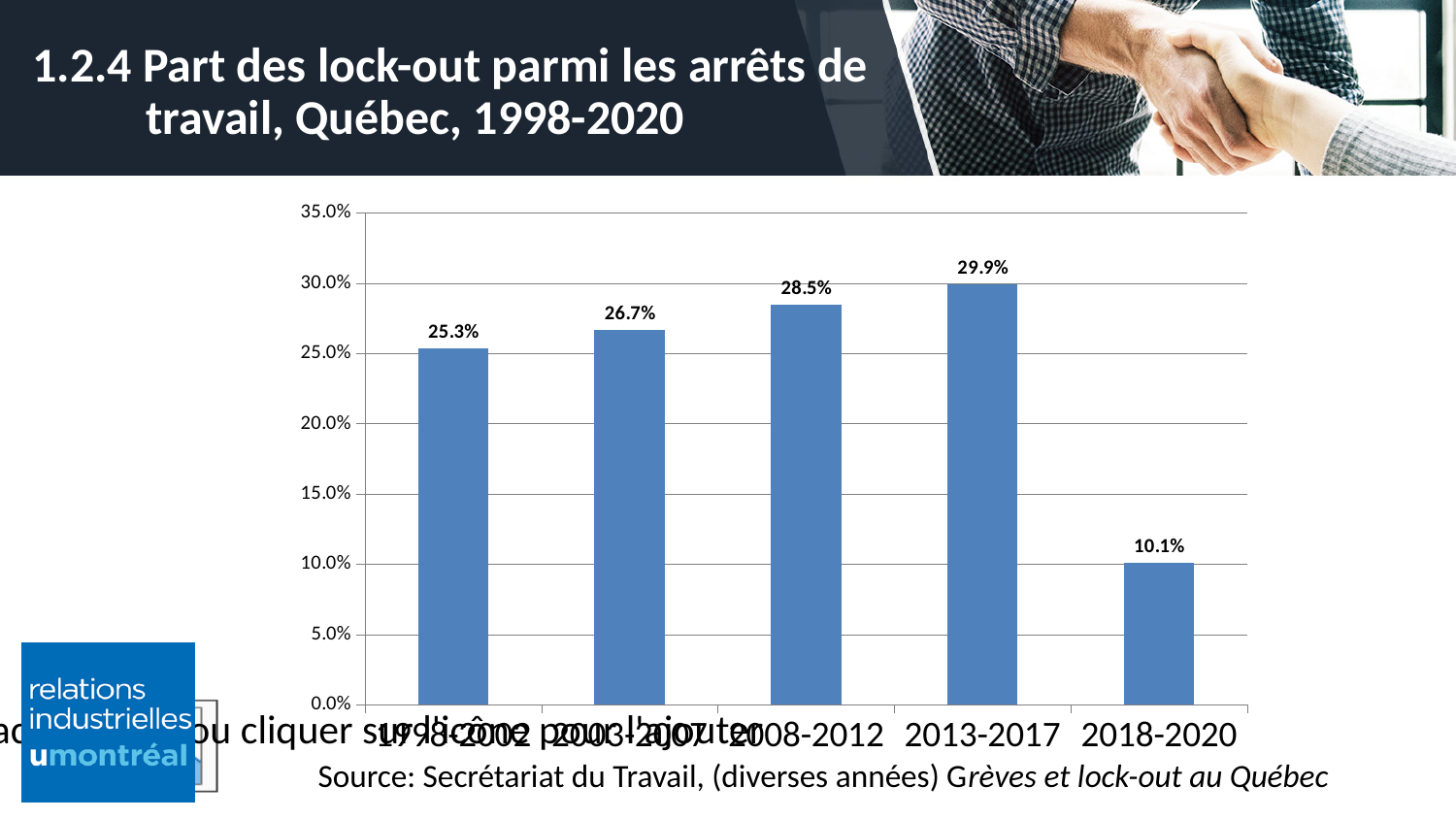
Which is larger, the value for 2008-2012 or the value for 2018-2020? 2008-2012 What is the value for 2008-2012? 28.5% What is the difference between the values for 2013-2017 and 2008-2012? 1.4% What is the value for 2018-2020? 10.1% How many bars are shown in the chart? 5 Which period has the lowest value? 2018-2020 What kind of chart is shown on the slide? bar chart What is the value shown on the leftmost bar of the chart? 25.3% What is the value for 2013-2017? 29.9% Which period has the highest value? 2013-2017 Is the value for 2018-2020 greater or less than 15.0%? less What is the difference between the values for 2013-2017 and 2018-2020? 19.8%